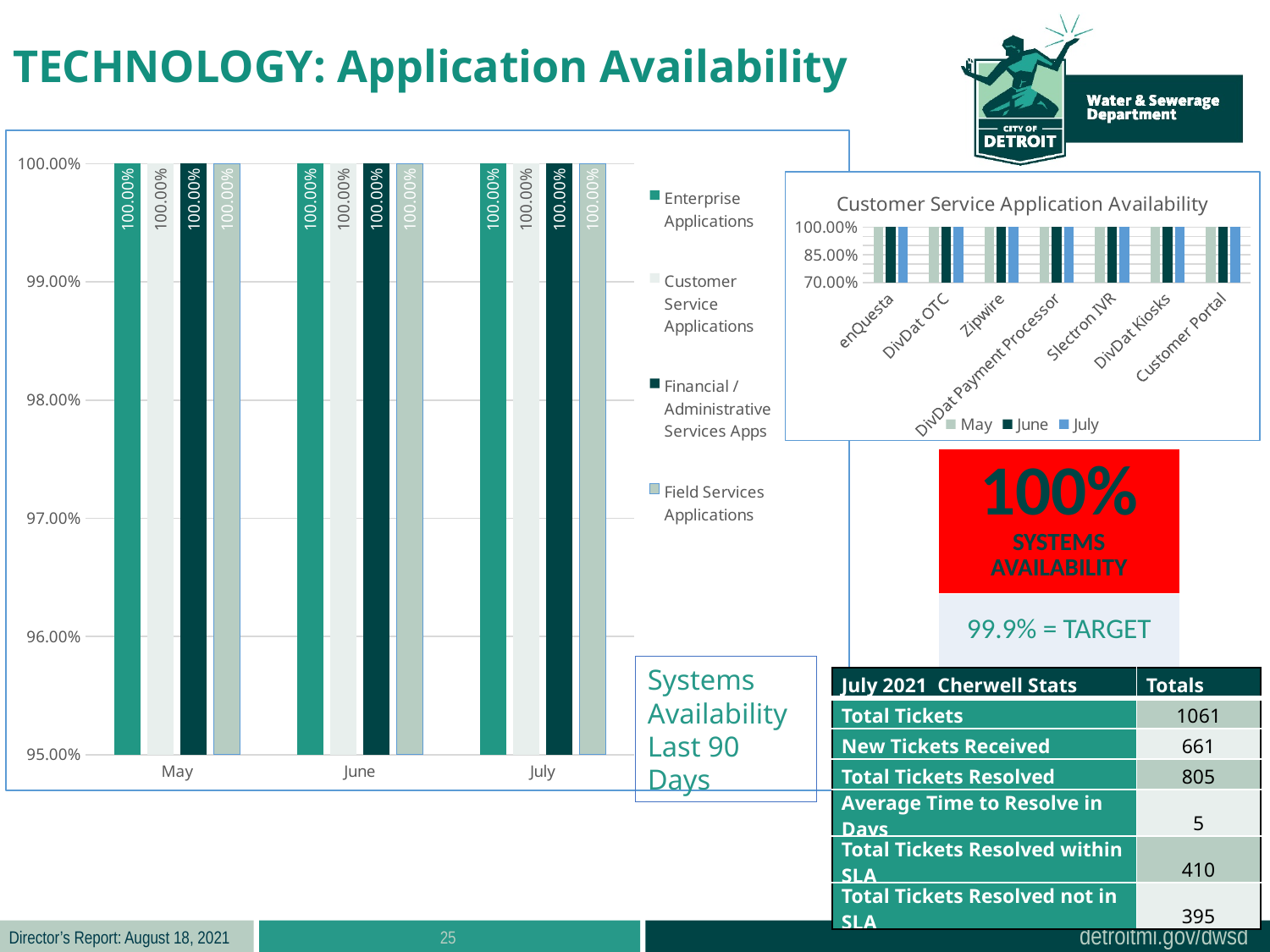
What is the title of the smaller chart on the right side of the slide? Customer Service Application Availability What kind of chart is the Systems Availability Last 90 Days chart? Bar chart In the Systems Availability Last 90 Days chart, do the Enterprise Applications values rise, fall or stay flat from May to July? Stay flat In the Customer Service Application Availability chart, is the July value for Zipwire greater or less than 85.00%? greater How many series does the legend of the Systems Availability Last 90 Days chart list? 4 In the Systems Availability Last 90 Days chart, what is the value for Financial / Administrative Services Apps in June? 100.00% How many months are shown on the x axis of the Systems Availability Last 90 Days chart? 3 How many applications are shown on the x axis of the Customer Service Application Availability chart? 7 In the Systems Availability Last 90 Days chart, what is the value for Enterprise Applications in May? 100.00% How many series does the legend of the Customer Service Application Availability chart list? 3 In the Systems Availability Last 90 Days chart, what is the difference between the Customer Service Applications value in May and in July? 0.00% In the Systems Availability Last 90 Days chart, what is the value for Field Services Applications in July? 100.00%